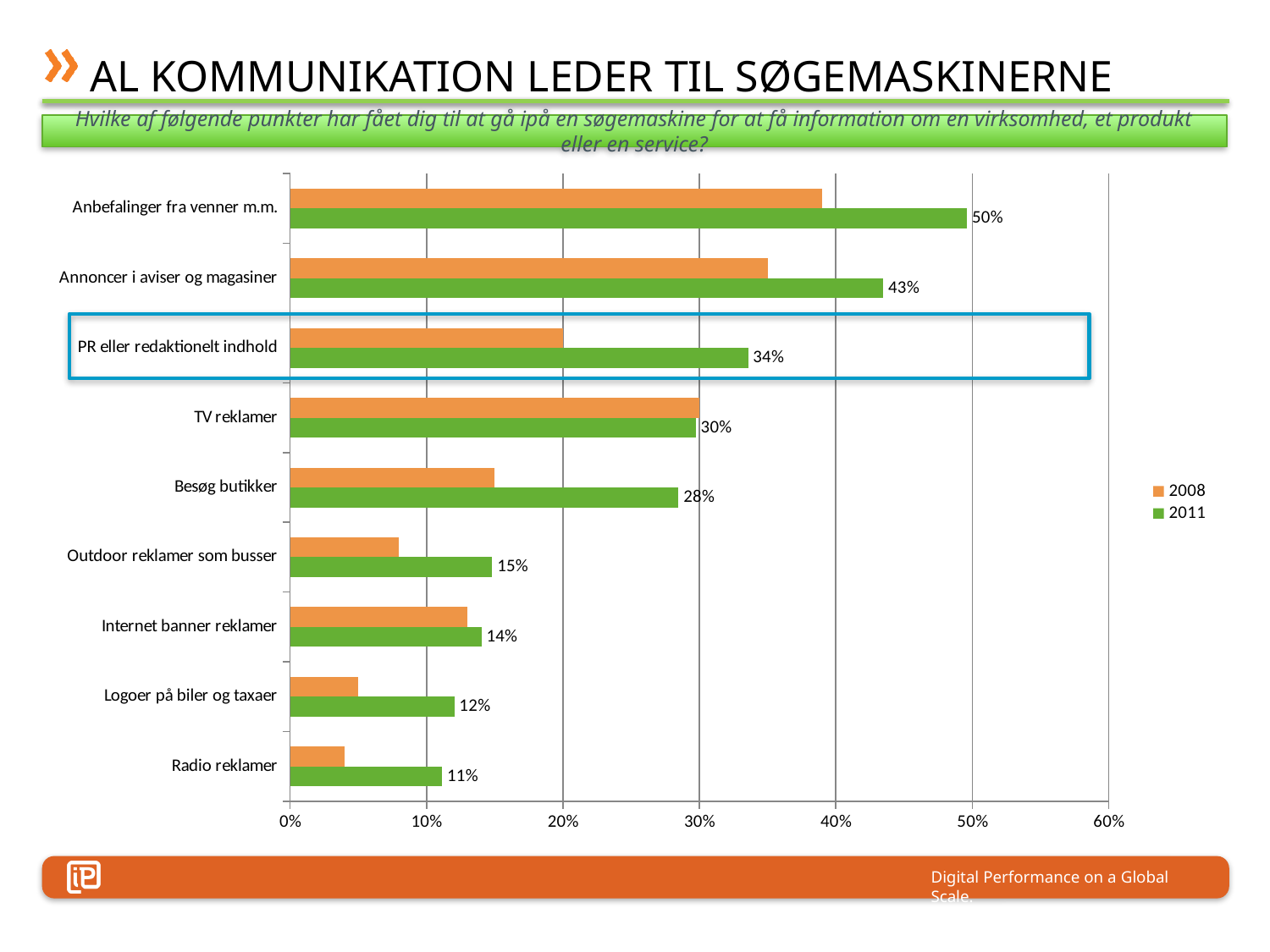
Is the 2008 value for Radio reklamer greater or less than 10%? less Is the 2008 value for Anbefalinger fra venner m.m. greater or less than 30%? greater What kind of chart is shown on the slide? Bar chart Which category has the highest 2011 value? Anbefalinger fra venner m.m. How many categories are shown on the chart? 9 How many series does the legend list? 2 What is the 2011 value for PR eller redaktionelt indhold? 34% What is the difference between the 2011 values for Annoncer i aviser og magasiner and PR eller redaktionelt indhold? 9 percentage points What is the 2011 value for Anbefalinger fra venner m.m.? 50% For 2011, which is larger: TV reklamer or Besøg butikker? TV reklamer Which category has the lowest 2011 value? Radio reklamer What is the 2011 value for Besøg butikker? 28%